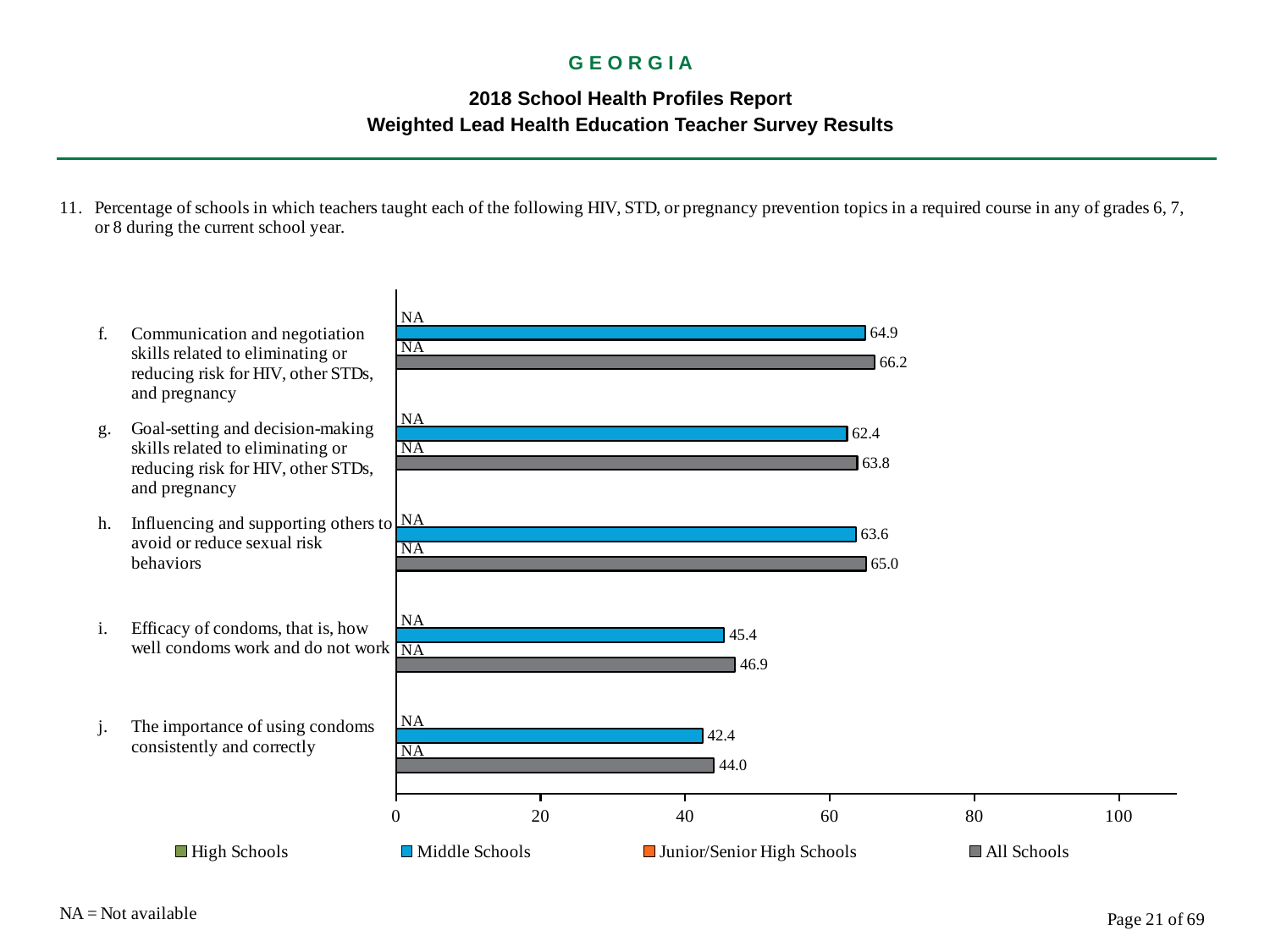
Which topic has the highest All Schools value? Communication and negotiation skills related to eliminating or reducing risk for HIV, other STDs, and pregnancy What is the All Schools value for 'Efficacy of condoms, that is, how well condoms work and do not work'? 46.9 What is the Middle Schools value for 'Influencing and supporting others to avoid or reduce sexual risk behaviors'? 63.6 What is the All Schools value for 'The importance of using condoms consistently and correctly'? 44.0 How many series does the legend list? 4 Is the Middle Schools value for 'The importance of using condoms consistently and correctly' greater or less than 60? less Which is larger for 'Efficacy of condoms, that is, how well condoms work and do not work': the Middle Schools value or the All Schools value? All Schools How many topics are listed on the chart? 5 What kind of chart is shown on the slide? bar chart Which topic has the lowest Middle Schools value? The importance of using condoms consistently and correctly What is the Middle Schools value for 'Communication and negotiation skills related to eliminating or reducing risk for HIV, other STDs, and pregnancy'? 64.9 What is the difference between the All Schools and Middle Schools values for 'Goal-setting and decision-making skills related to eliminating or reducing risk for HIV, other STDs, and pregnancy'? 1.4